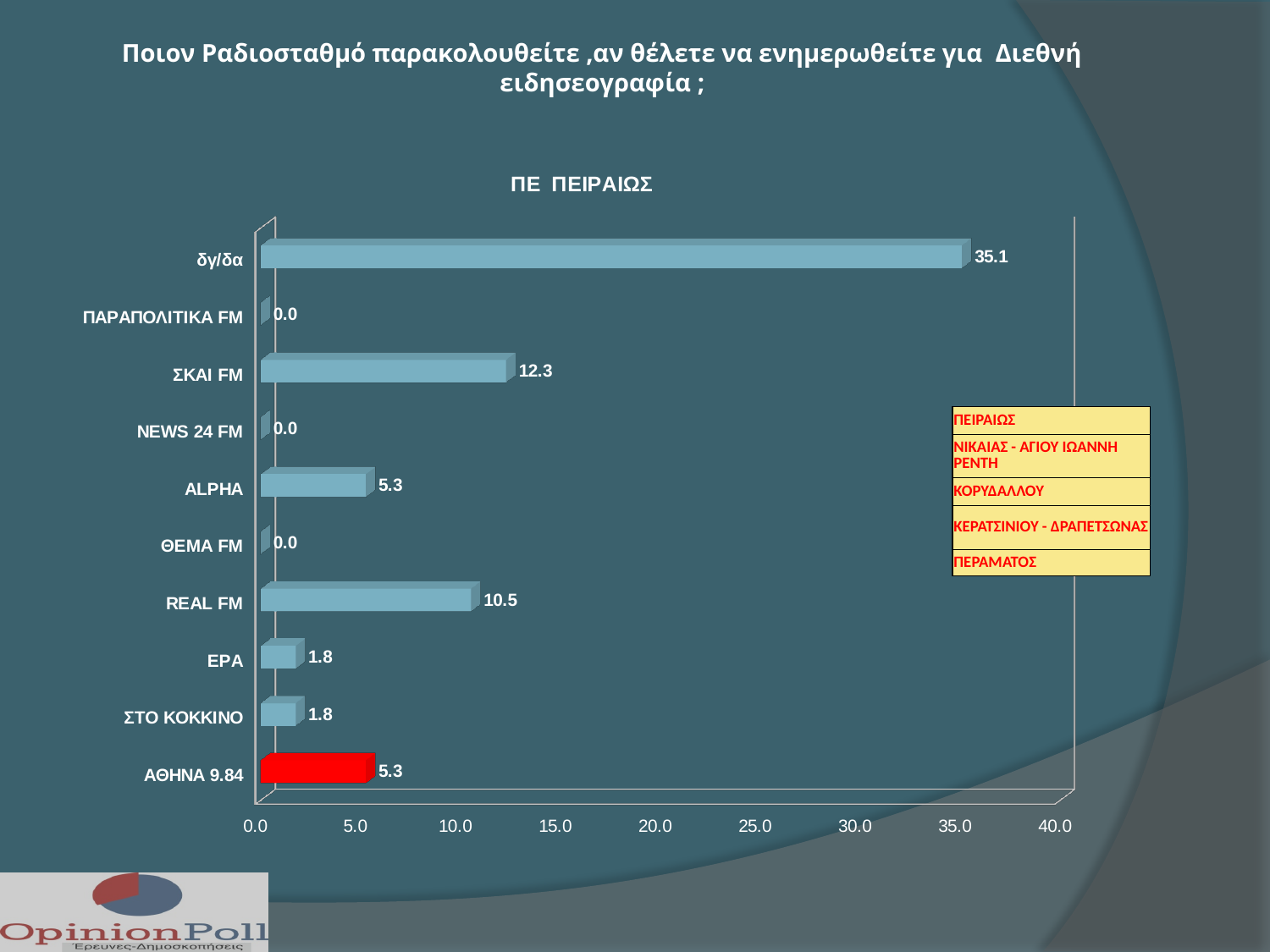
Which category's bar is coloured red? ΑΘΗΝΑ 9.84 What is the difference between the values for δγ/δα and ΣΚΑΙ FM? 22.8 What is the difference between the values for ΣΚΑΙ FM and REAL FM? 1.8 Which category has the highest value? δγ/δα Is the value for δγ/δα greater or less than 30.0? greater What kind of chart is shown on the slide? bar chart How many categories are shown on the chart? 10 What is the value for ΕΡΑ? 1.8 What is the value for ΑΘΗΝΑ 9.84? 5.3 Which has a larger value, ΣΚΑΙ FM or REAL FM? ΣΚΑΙ FM What is the value for ΣΚΑΙ FM? 12.3 What is the value for REAL FM? 10.5